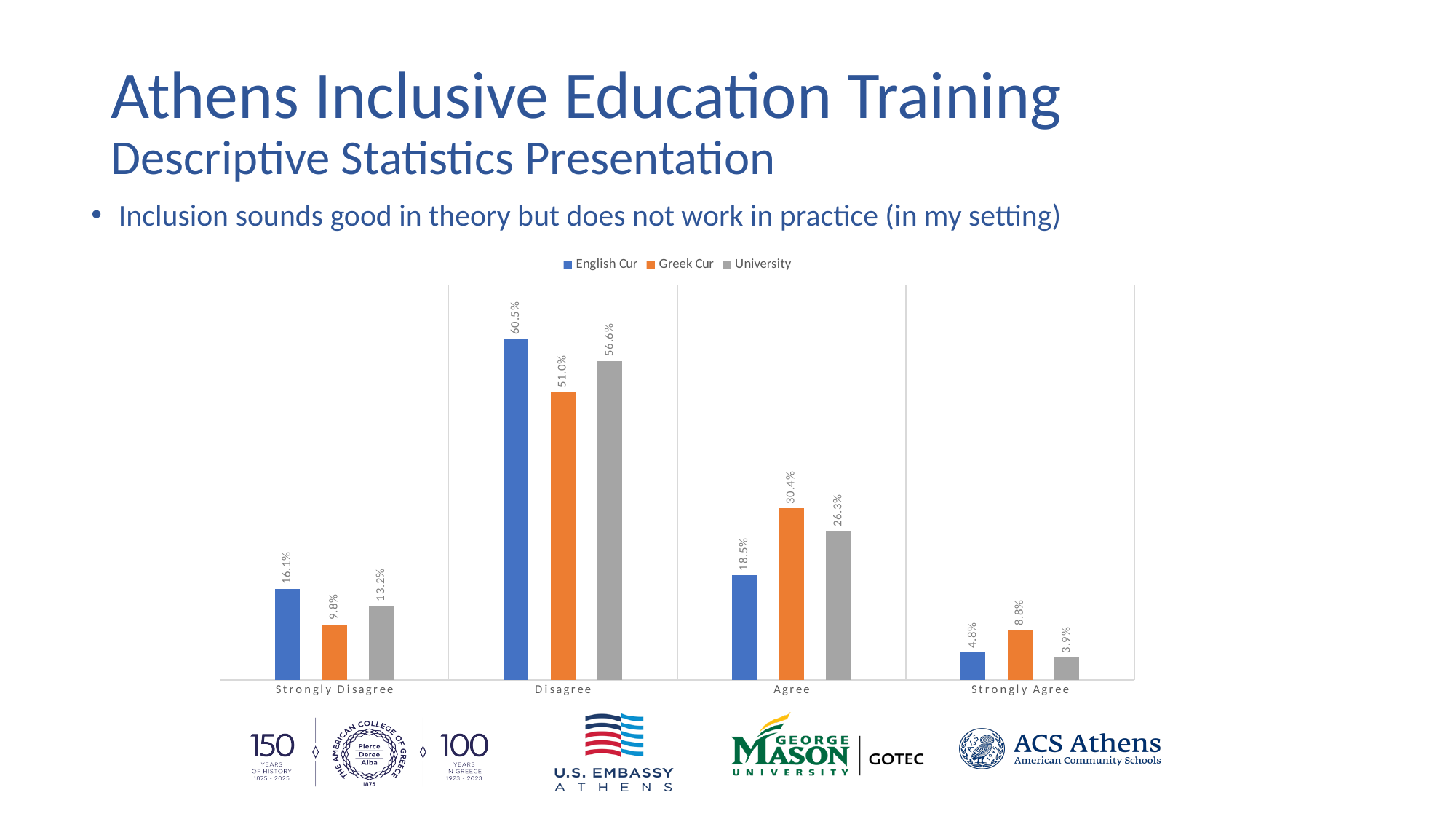
What is the value for Greek Cur in the Strongly Disagree category? 9.8% In the Agree category, which is larger: the Greek Cur value or the University value? Greek Cur Which category has the highest value for the University series? Disagree How many series does the legend list? 3 What is the value for Greek Cur in the Agree category? 30.4% What kind of chart is shown on the slide? Bar chart What is the difference between the English Cur and Greek Cur values in the Disagree category? 9.5% What is the value for English Cur in the Disagree category? 60.5% Which category has the lowest value for the English Cur series? Strongly Agree Which series is shown in orange in the legend? Greek Cur How many categories are shown on the x axis? 4 What is the value for University in the Strongly Agree category? 3.9%